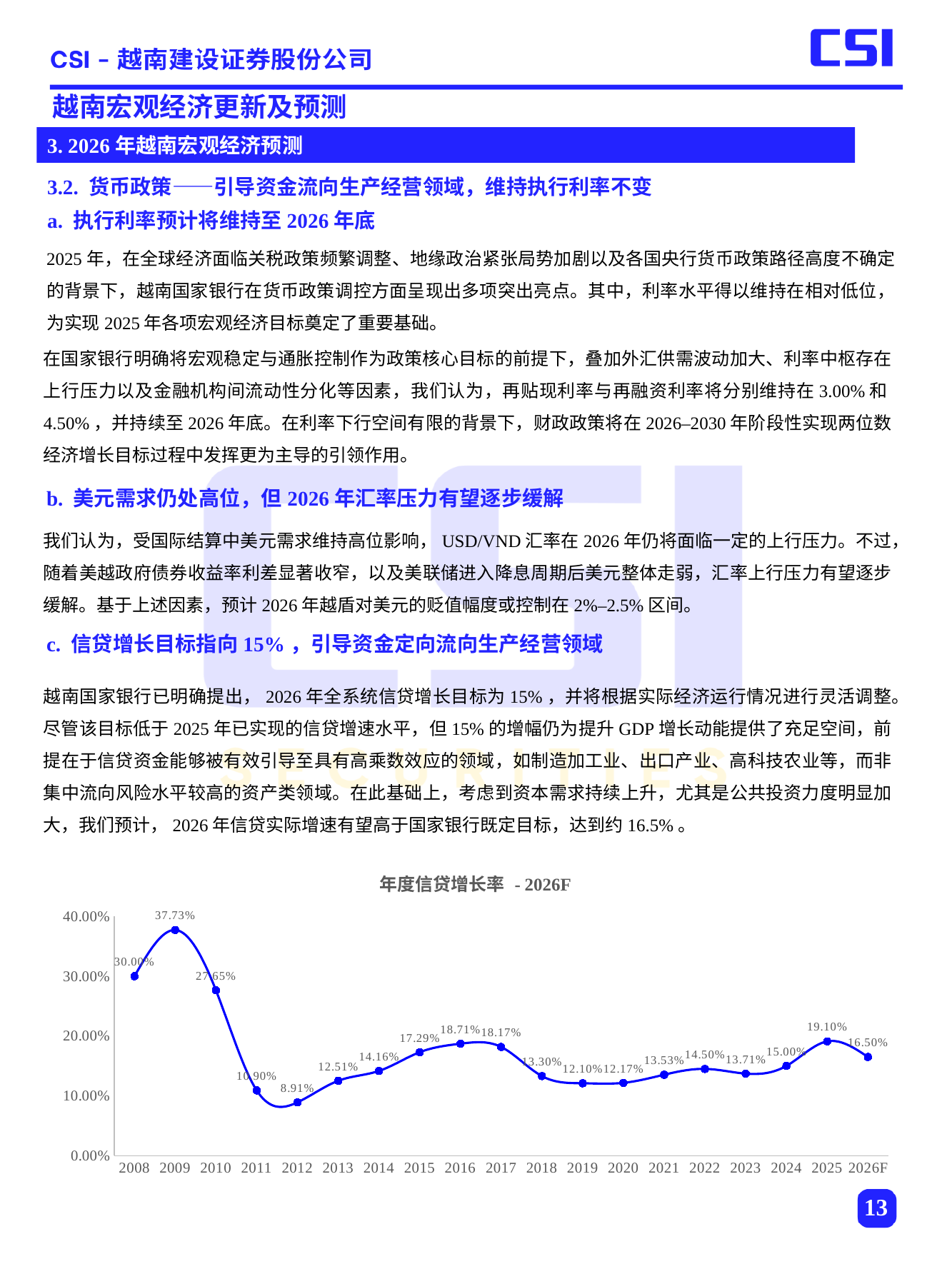
How many data points are plotted on the chart? 19 What is the title of the chart? 年度信贷增长率 - 2026F What is the credit growth rate for 2012? 8.91% What is the credit growth rate for 2025? 19.10% Which year has the lowest credit growth rate? 2012 Does the credit growth rate rise or fall from 2008 to 2009? rise What is the difference between the credit growth rate in 2025 and the forecast for 2026F? 2.60% What is the forecast credit growth rate for 2026F? 16.50% Which year has a higher credit growth rate, 2016 or 2018? 2016 What is the credit growth rate for 2009? 37.73% What type of chart is shown on the slide? line chart Which year has the highest credit growth rate? 2009